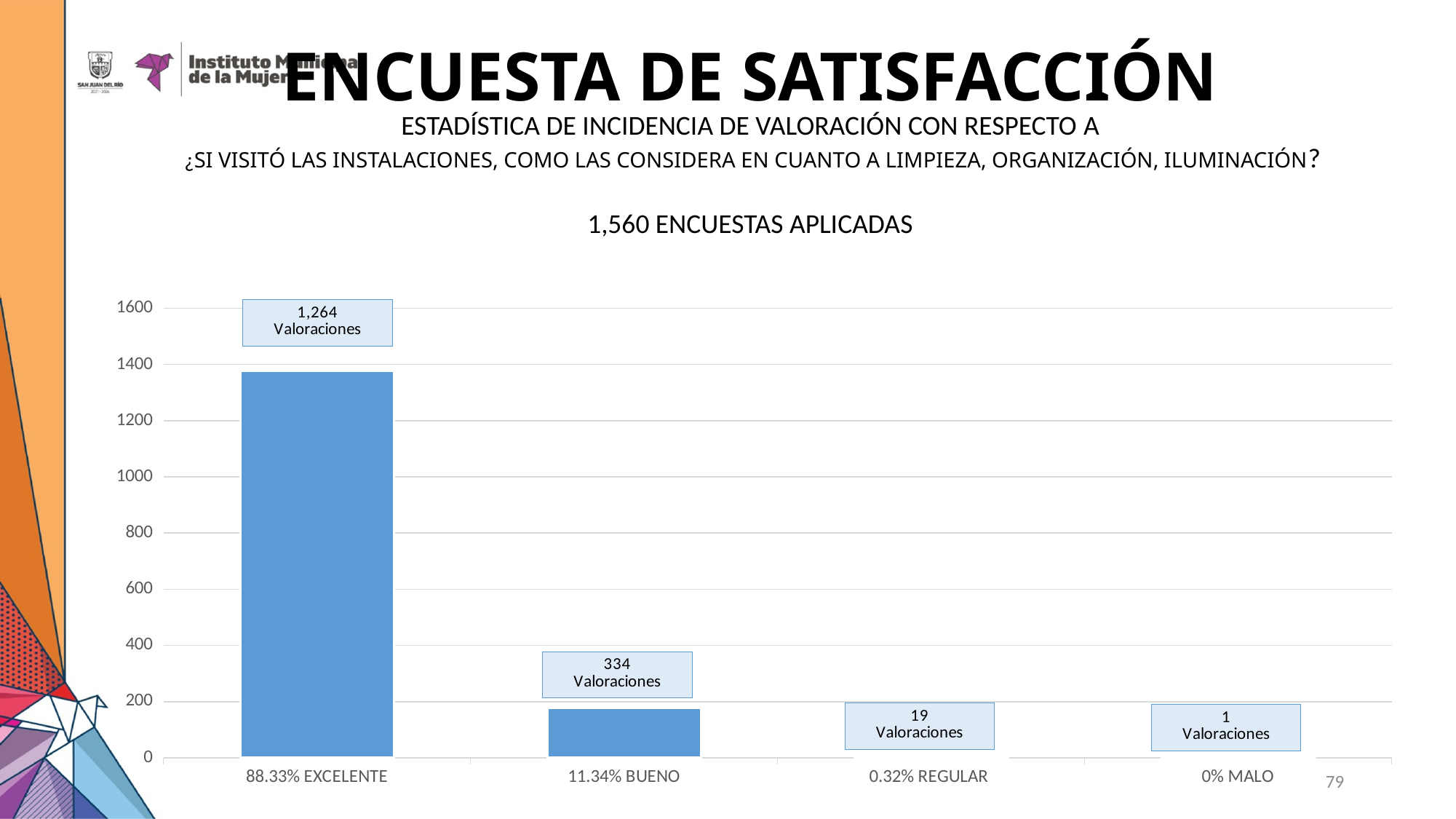
What percentage is shown in the x-axis label for the BUENO category? 11.34% How many valoraciones are labelled for the EXCELENTE category? 1,264 Valoraciones How many categories are shown on the x axis of the chart? 4 How many valoraciones are labelled for the BUENO category? 334 Valoraciones Which category has the lowest number of valoraciones? 0% MALO Which category has the highest number of valoraciones? 88.33% EXCELENTE Is the bar for EXCELENTE greater or less than 1000 on the axis? greater What is the difference between the labelled valoraciones for EXCELENTE and BUENO? 930 How many valoraciones are labelled for the REGULAR category? 19 Valoraciones What kind of chart is shown on the slide? bar chart How many valoraciones are labelled for the MALO category? 1 Valoraciones Which has more valoraciones, BUENO or REGULAR? BUENO